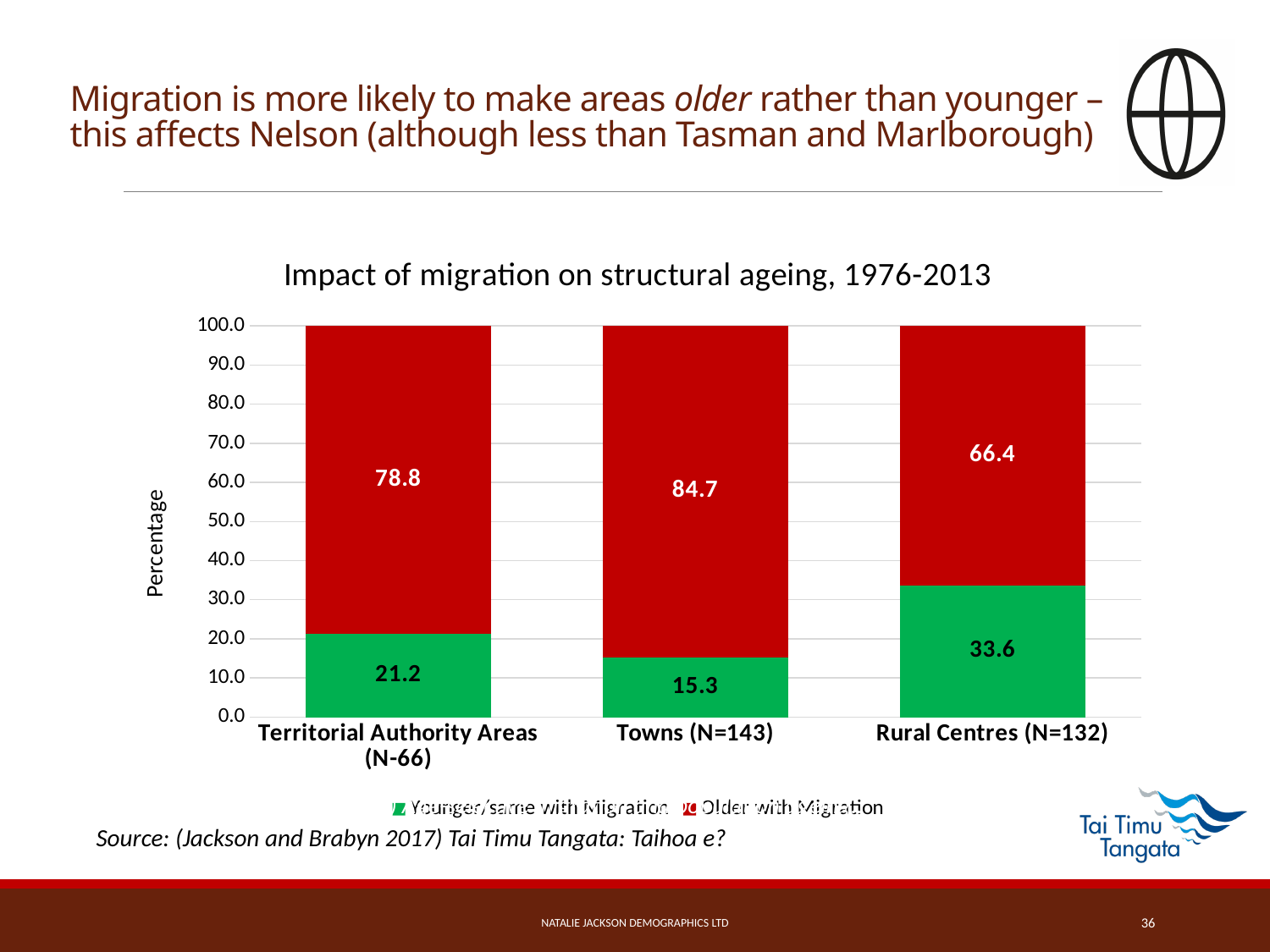
What is the value for 'Younger/same with Migration' for Rural Centres (N=132)? 33.6 Is the 'Older with Migration' value for Territorial Authority Areas (N-66) greater or less than 70.0? greater Which category has the lowest value for 'Younger/same with Migration'? Towns (N=143) Which is larger: the 'Younger/same with Migration' value for Rural Centres (N=132) or for Territorial Authority Areas (N-66)? Rural Centres (N=132) How many categories are shown on the x axis? 3 How many series does the legend list? 2 What is the value for 'Younger/same with Migration' for Territorial Authority Areas (N-66)? 21.2 Which category has the highest value for 'Older with Migration'? Towns (N=143) What is the title of the chart? Impact of migration on structural ageing, 1976-2013 What is the difference between the 'Older with Migration' values for Towns (N=143) and Rural Centres (N=132)? 18.3 What kind of chart is shown on the slide? Stacked bar chart What is the value for 'Older with Migration' for Towns (N=143)? 84.7